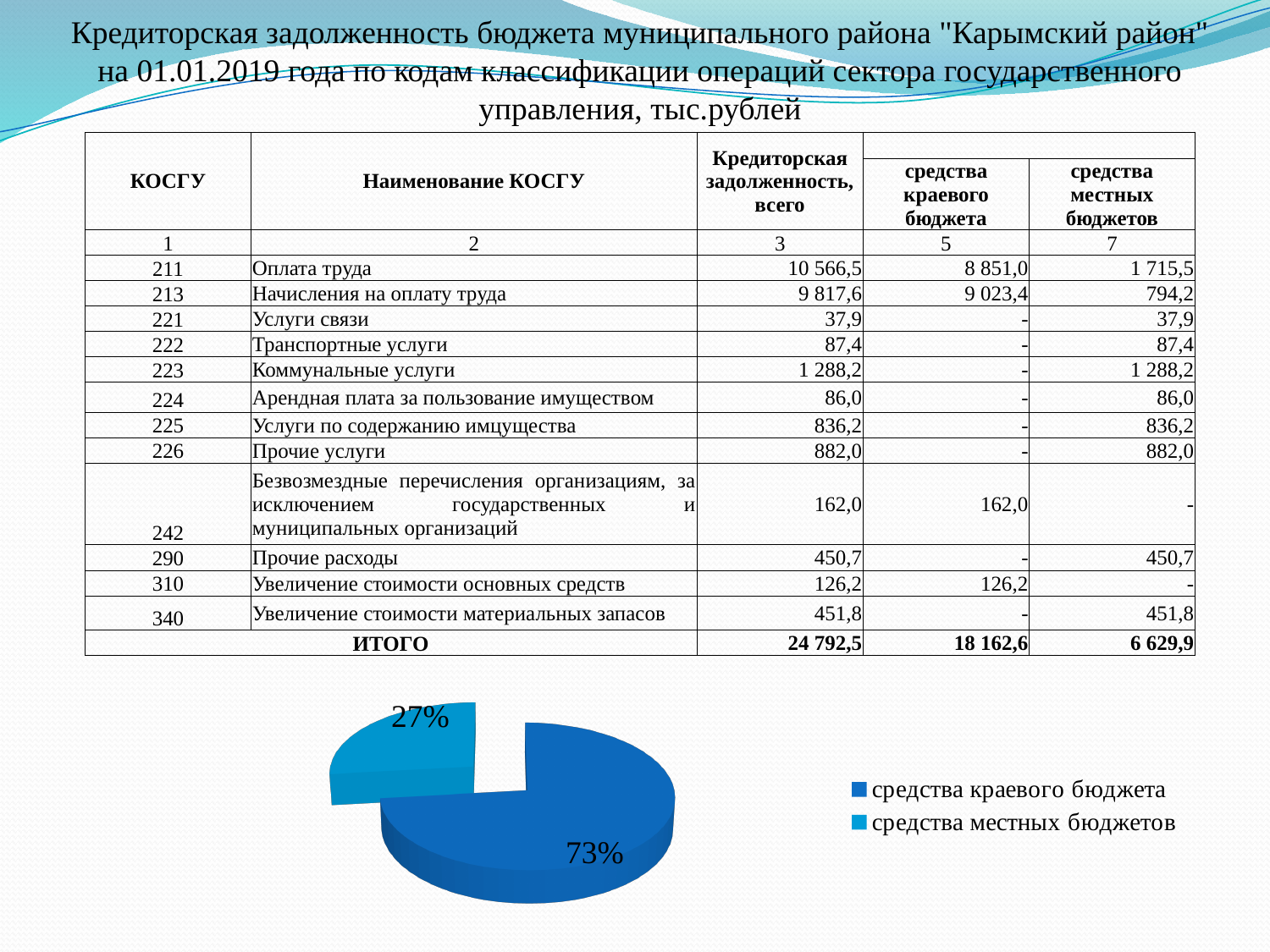
By how many percentage points does the share of средства краевого бюджета exceed the share of средства местных бюджетов in the pie chart? 46 What colour is the slice for средства краевого бюджета in the pie chart? dark blue What kind of chart is shown at the bottom of the slide? pie chart Which slice of the pie chart is the largest? средства краевого бюджета How many entries does the pie chart's legend list? 2 Is the share of средства краевого бюджета in the pie chart greater or less than 50%? greater How many slices does the pie chart have? 2 Which slice of the pie chart is the smallest? средства местных бюджетов In the pie chart, what share is labelled for средства местных бюджетов? 27% In the pie chart, what share is labelled for средства краевого бюджета? 73% In the pie chart, which is larger: the share of средства краевого бюджета or the share of средства местных бюджетов? средства краевого бюджета What do the two labelled shares in the pie chart add up to? 100%